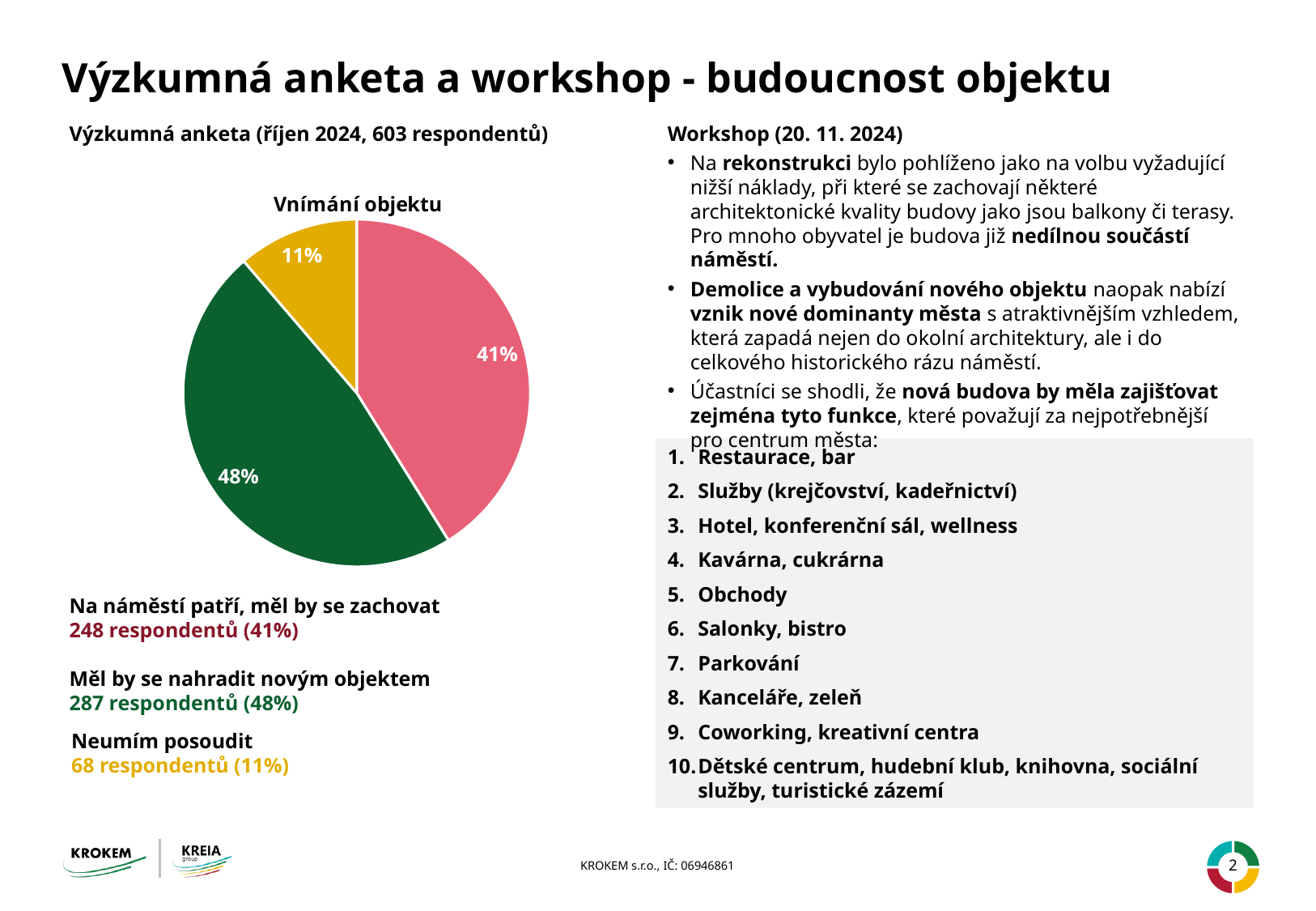
In the pie chart "Vnímání objektu", what is the difference in percentage points between the 48% slice and the 41% slice? 7 percentage points How many slices does the pie chart "Vnímání objektu" have? 3 What is the title of the pie chart? Vnímání objektu In the pie chart "Vnímání objektu", what share is shown for the pink slice (Na náměstí patří, měl by se zachovat)? 41% How many respondents answered "Neumím posoudit" according to the text below the pie chart? 68 respondentů Which category has the smallest slice in the pie chart "Vnímání objektu"? Neumím posoudit In the pie chart "Vnímání objektu", what share is shown for the yellow slice (Neumím posoudit)? 11% Which category has the largest slice in the pie chart "Vnímání objektu"? Měl by se nahradit novým objektem In the pie chart "Vnímání objektu", what share is shown for the green slice (Měl by se nahradit novým objektem)? 48% In the pie chart "Vnímání objektu", which slice is larger: "Na náměstí patří, měl by se zachovat" or "Neumím posoudit"? Na náměstí patří, měl by se zachovat What kind of chart is shown under the title "Vnímání objektu"? pie chart What colour is the slice representing "Neumím posoudit" in the pie chart? yellow